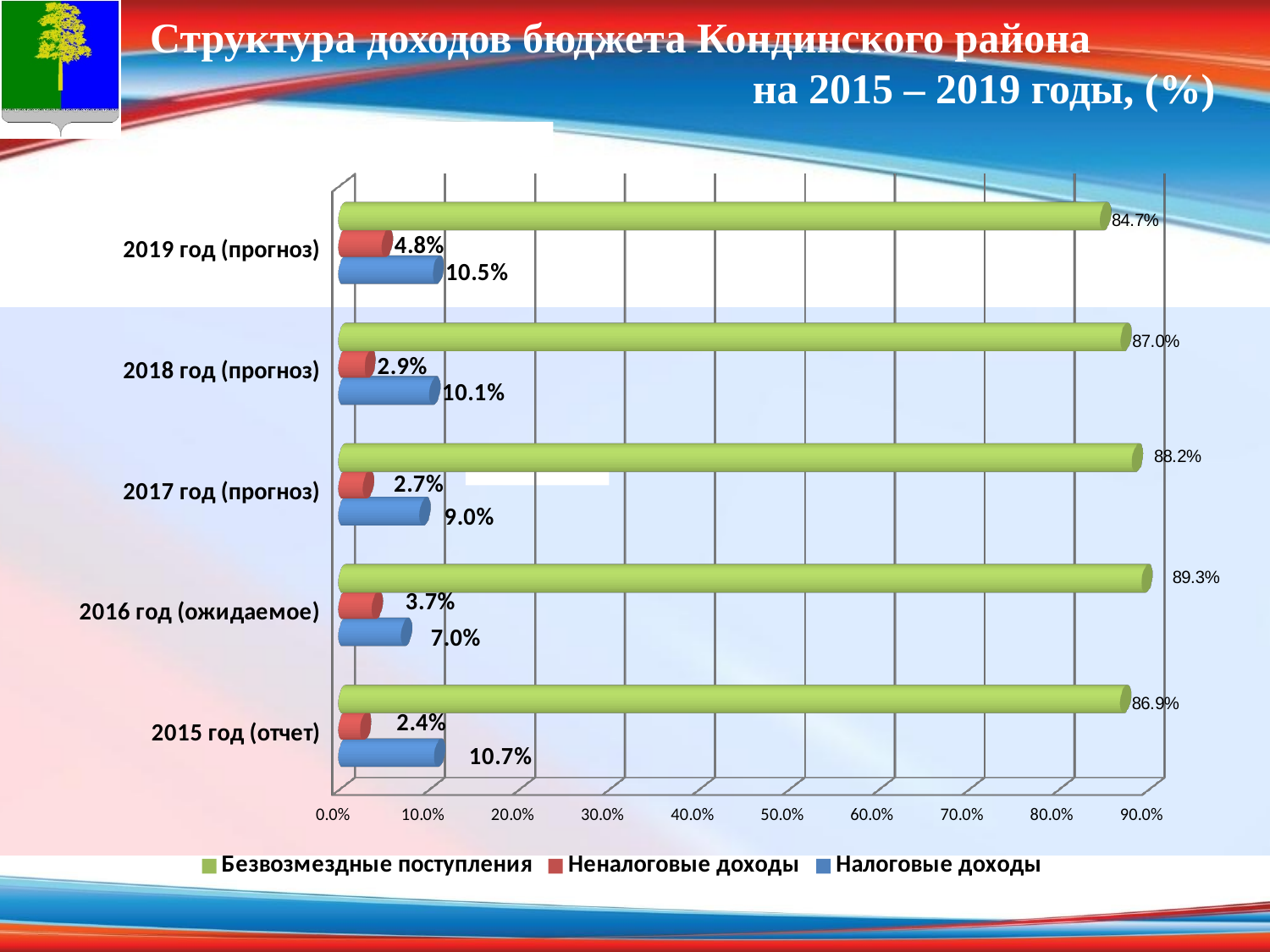
How many year categories are shown on the chart? 5 What is the value of Безвозмездные поступления for 2019 год (прогноз)? 84.7% What kind of chart is shown on the slide? Bar chart In which year is Безвозмездные поступления the highest? 2016 год (ожидаемое) What is the value of Налоговые доходы for 2017 год (прогноз)? 9.0% What is the value of Неналоговые доходы for 2016 год (ожидаемое)? 3.7% How many series does the legend list? 3 What is the difference between Налоговые доходы for 2019 год (прогноз) and 2016 год (ожидаемое)? 3.5% What is the value of Налоговые доходы for 2015 год (отчет)? 10.7% In which year is Неналоговые доходы the lowest? 2015 год (отчет) Which is larger: Неналоговые доходы for 2018 год (прогноз) or for 2019 год (прогноз)? 2019 год (прогноз) Which colour represents Налоговые доходы in the chart? Blue